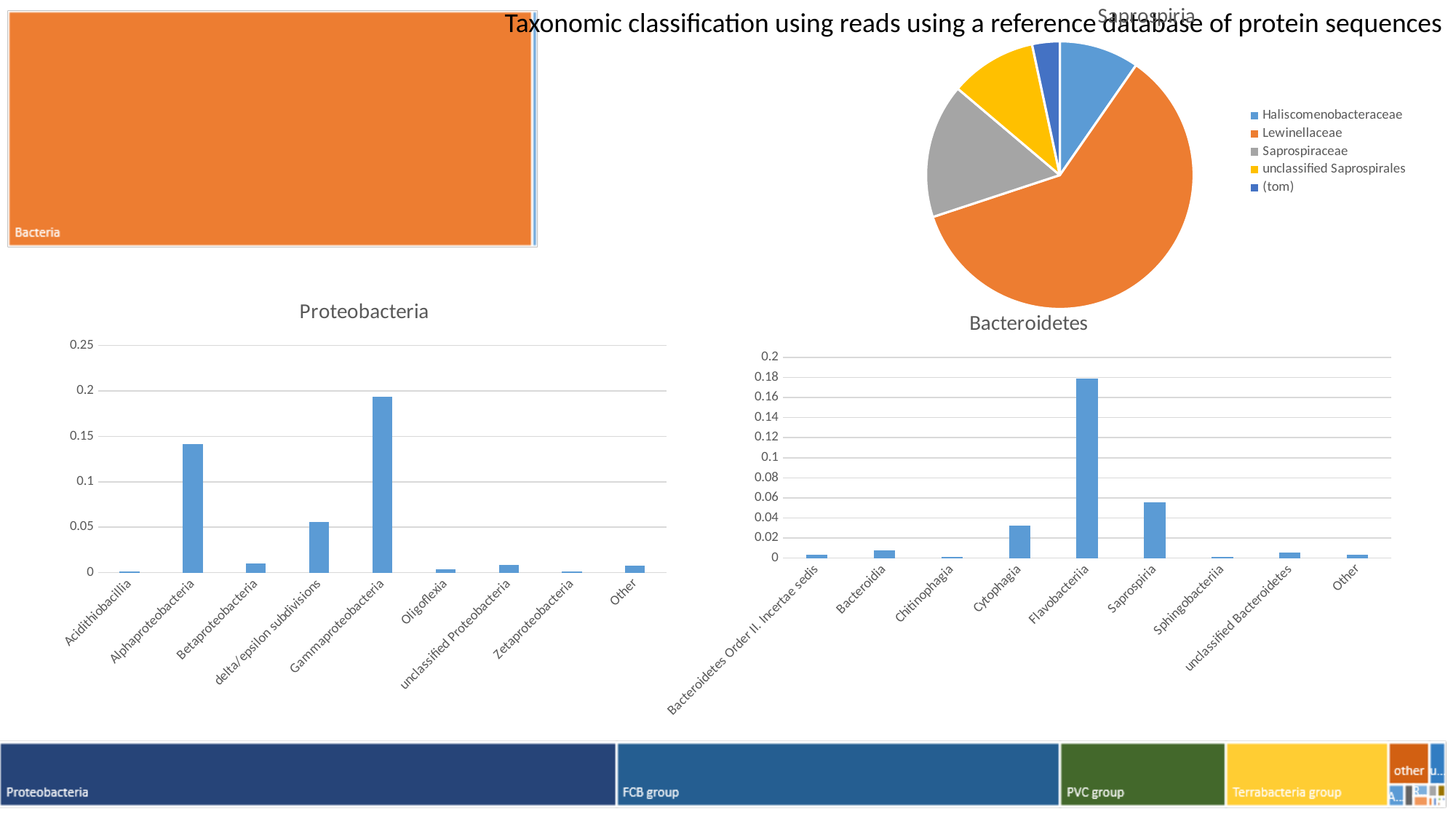
In the Bacteroidetes chart, is the value for Cytophagia greater or less than 0.04? less In the Proteobacteria chart, is the value for Gammaproteobacteria greater or less than 0.15? greater In the Proteobacteria chart, which is larger, Alphaproteobacteria or Betaproteobacteria? Alphaproteobacteria In the Proteobacteria chart, is the value for delta/epsilon subdivisions greater or less than 0.1? less In the Bacteroidetes chart, which category has the highest value? Flavobacteriia In the pie chart at the top right, which legend entry has the largest slice? Lewinellaceae How many categories are shown on the x axis of the Proteobacteria chart? 9 What kind of chart is the Bacteroidetes chart? bar chart In the Bacteroidetes chart, which is larger, Saprospiria or Cytophagia? Saprospiria In the Proteobacteria chart, which category has the highest value? Gammaproteobacteria